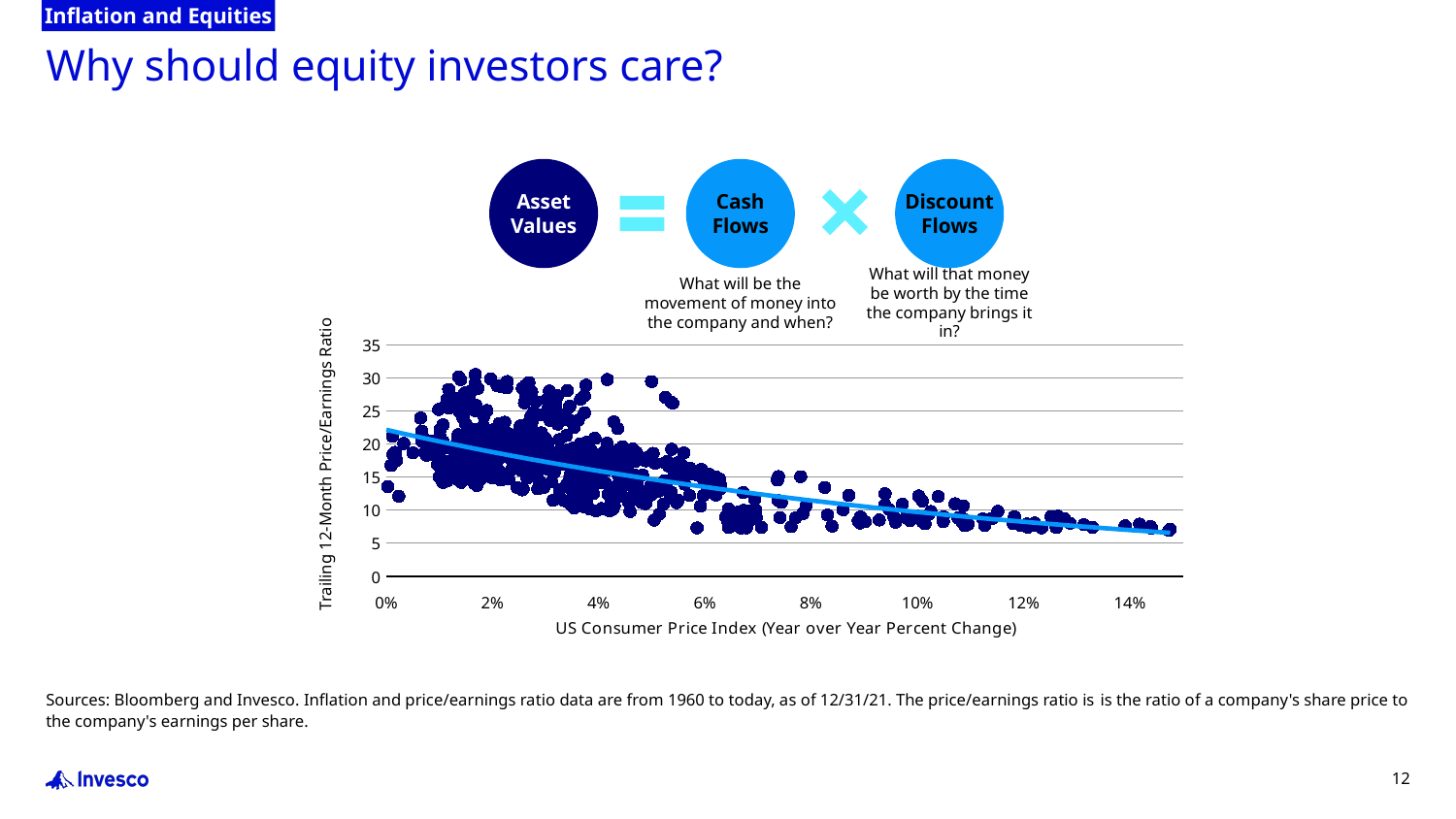
What kind of chart is shown on the slide? scatter chart Is the trend line's value at a 14% CPI change greater or less than 10? less What is the highest tick label shown on the x axis of the chart? 14% What is the title of the x axis of the chart? US Consumer Price Index (Year over Year Percent Change) What is the highest value shown on the y axis of the chart? 35 What is the title of the y axis of the chart? Trailing 12-Month Price/Earnings Ratio Is the trend line's value at a 0% CPI change greater or less than 15? greater Does the trend line slope upward or downward from left to right? downward As the US Consumer Price Index (year over year percent change) increases along the x axis, does the trailing 12-month price/earnings ratio generally rise or fall? fall